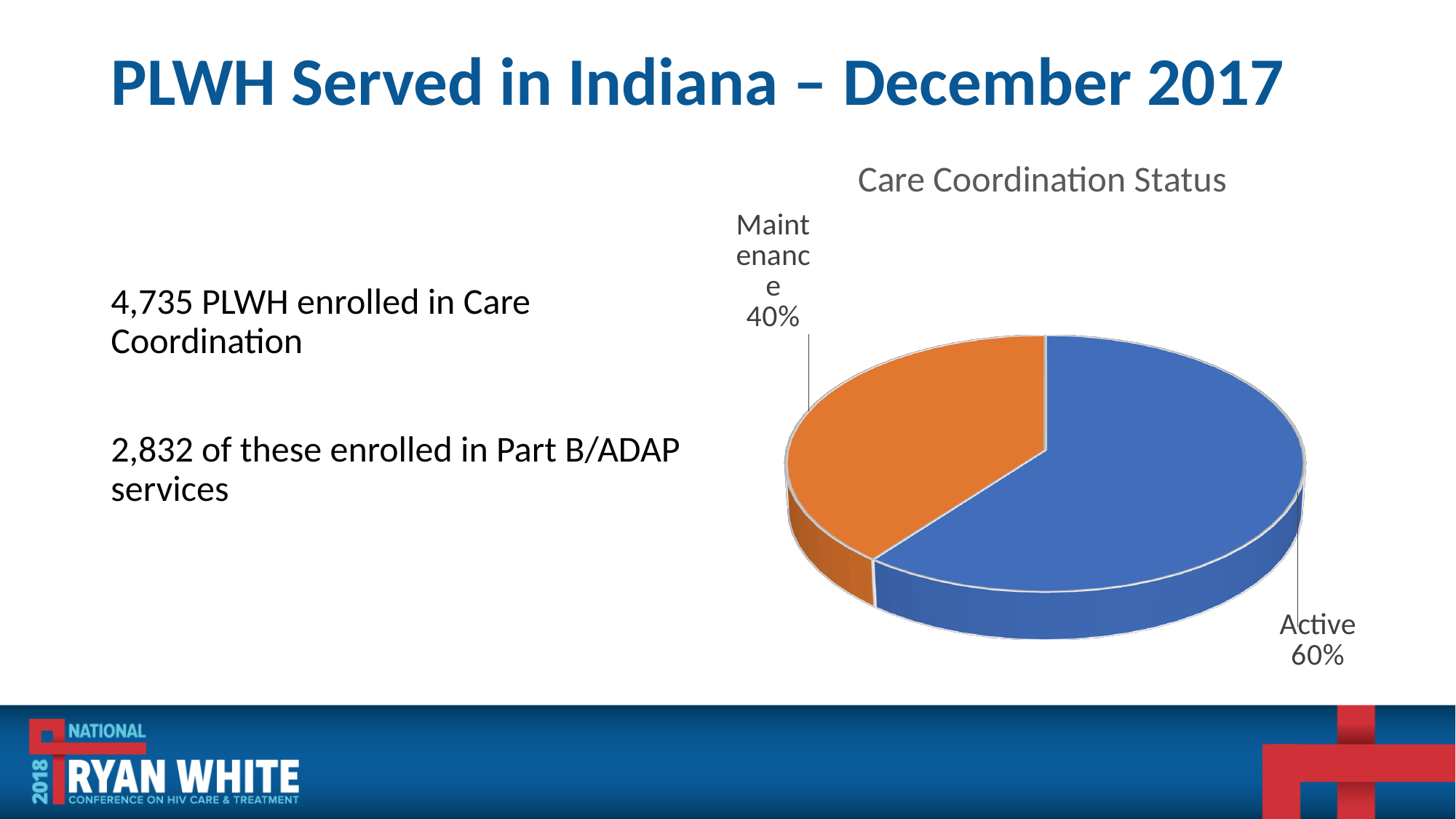
What is the difference in percentage points between the Active and Maintenance shares? 20% What is the title of the chart? Care Coordination Status What share of the pie does the Active slice represent? 60% Which category has the smallest share of the pie? Maintenance How many slices does the pie chart have? 2 What colour is the Active slice of the pie? blue Which is larger, the Active share or the Maintenance share? Active What share of the pie does the Maintenance slice represent? 40% What kind of chart is shown on the slide? pie chart Is the Maintenance share greater or less than 50%? less Which category has the largest share of the pie? Active